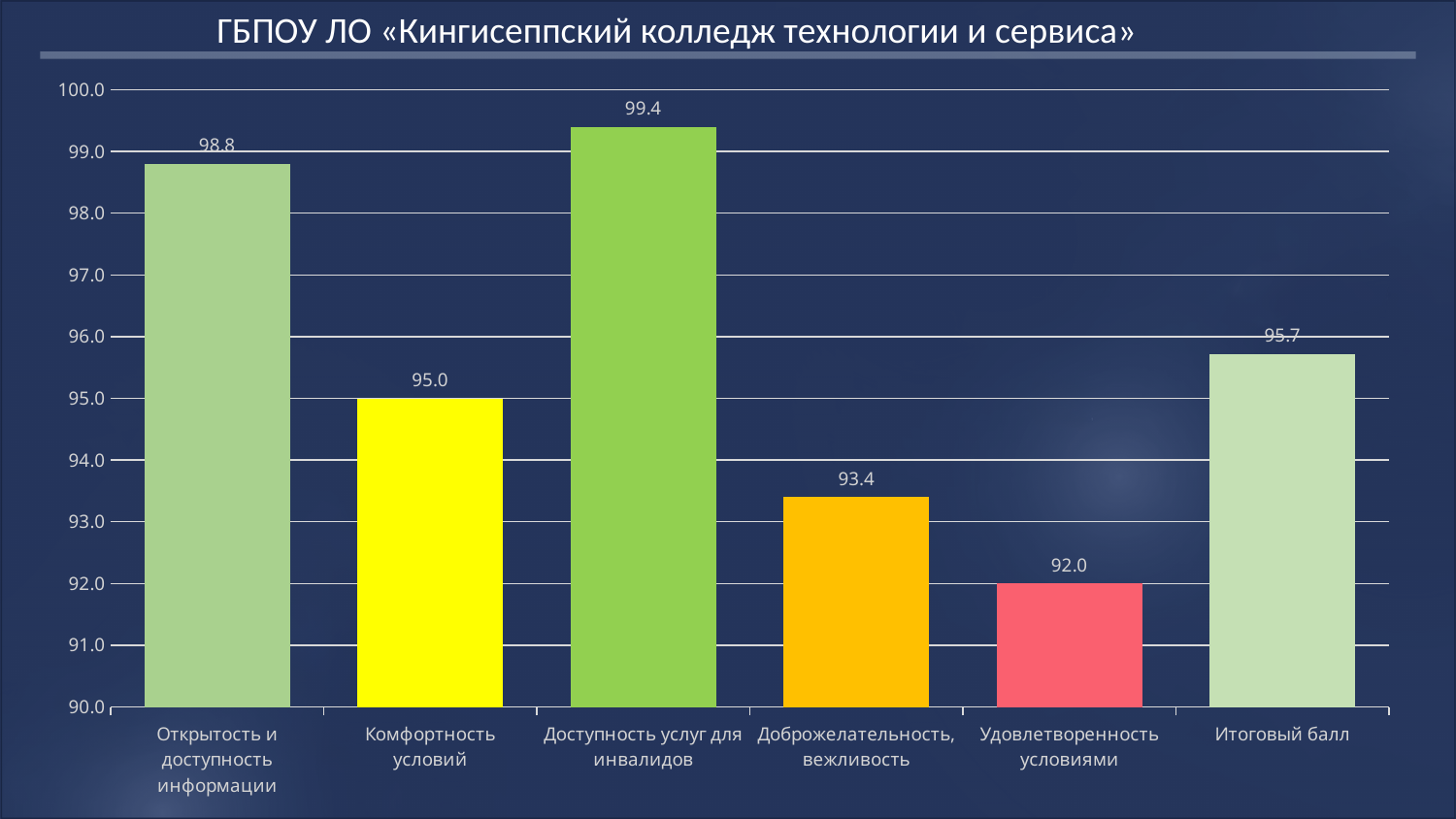
Which category has the lowest value? Удовлетворенность условиями What is the title of the slide? ГБПОУ ЛО «Кингисеппский колледж технологии и сервиса» Is the value for Доброжелательность, вежливость greater or less than 94.0? less What is the difference between the values for Открытость и доступность информации and Комфортность условий? 3.8 What is the value for Удовлетворенность условиями? 92.0 Which is larger: the value for Доброжелательность, вежливость or the value for Итоговый балл? Итоговый балл What is the value for Доступность услуг для инвалидов? 99.4 What colour is the bar for Комфортность условий? yellow What kind of chart is shown on the slide? bar chart Which category has the highest value? Доступность услуг для инвалидов How many categories are shown on the x axis? 6 What is the value for Итоговый балл? 95.7